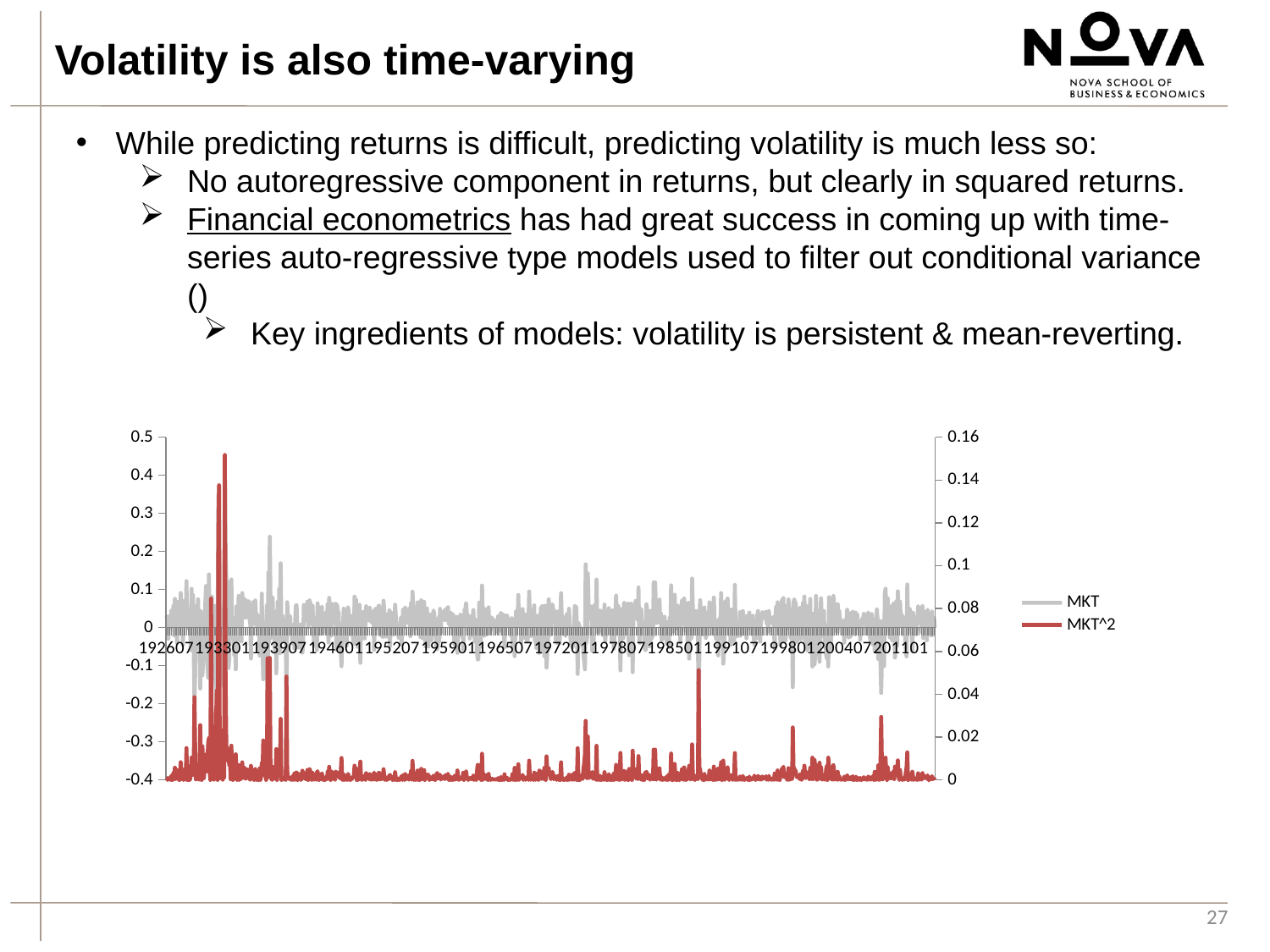
What are the names of the two series in the chart's legend? MKT and MKT^2 What is the first x-axis label shown on the chart? 192607 What is the maximum value shown on the left y-axis of the chart? 0.5 What is the maximum value shown on the right y-axis of the chart? 0.16 What is the last x-axis label shown on the chart? 201101 How many x-axis tick labels are printed on the chart? 14 Is the highest peak of the MKT^2 series greater or less than 0.12 on the right axis? greater How many series does the chart's legend list? 2 What kind of chart is shown on the slide? line chart Which series in the chart is drawn in red? MKT^2 What is the minimum value shown on the left y-axis of the chart? -0.4